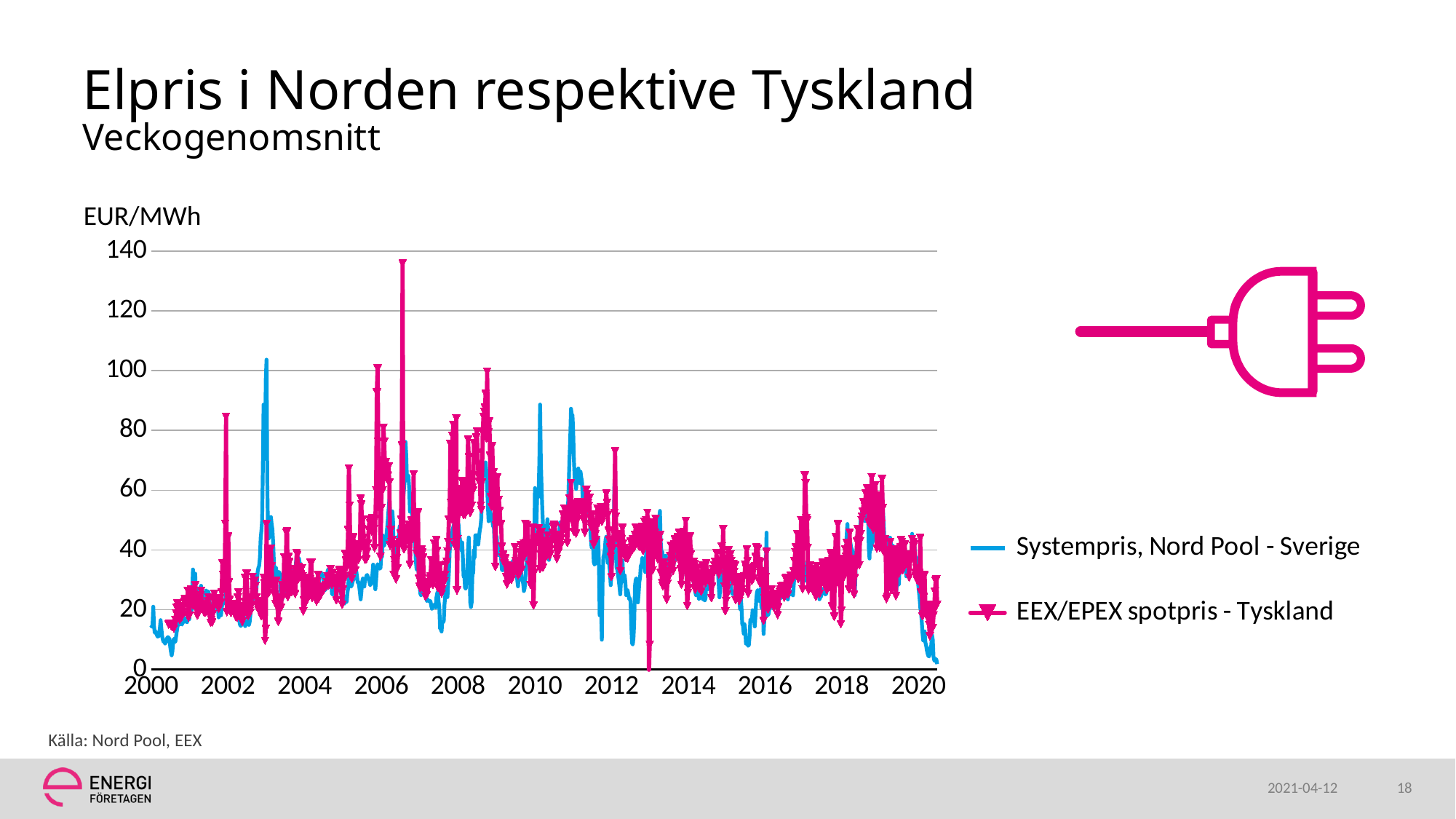
What unit is shown on the y axis of the chart? EUR/MWh Does the Systempris, Nord Pool - Sverige series rise or fall during 2020 at the right end of the chart? fall What is the first year label shown on the x axis of the chart? 2000 What kind of chart is shown on the slide? line chart Which series reaches the highest peak on the chart, Systempris, Nord Pool - Sverige or EEX/EPEX spotpris - Tyskland? EEX/EPEX spotpris - Tyskland Is the highest peak of the Systempris, Nord Pool - Sverige series greater or less than 100 EUR/MWh? greater How many series does the chart's legend list? 2 Is the highest peak of the Systempris, Nord Pool - Sverige series greater or less than 120 EUR/MWh? less Is the highest peak of the EEX/EPEX spotpris - Tyskland series greater or less than 120 EUR/MWh? greater What is the title of the chart on the slide? Elpris i Norden respektive Tyskland